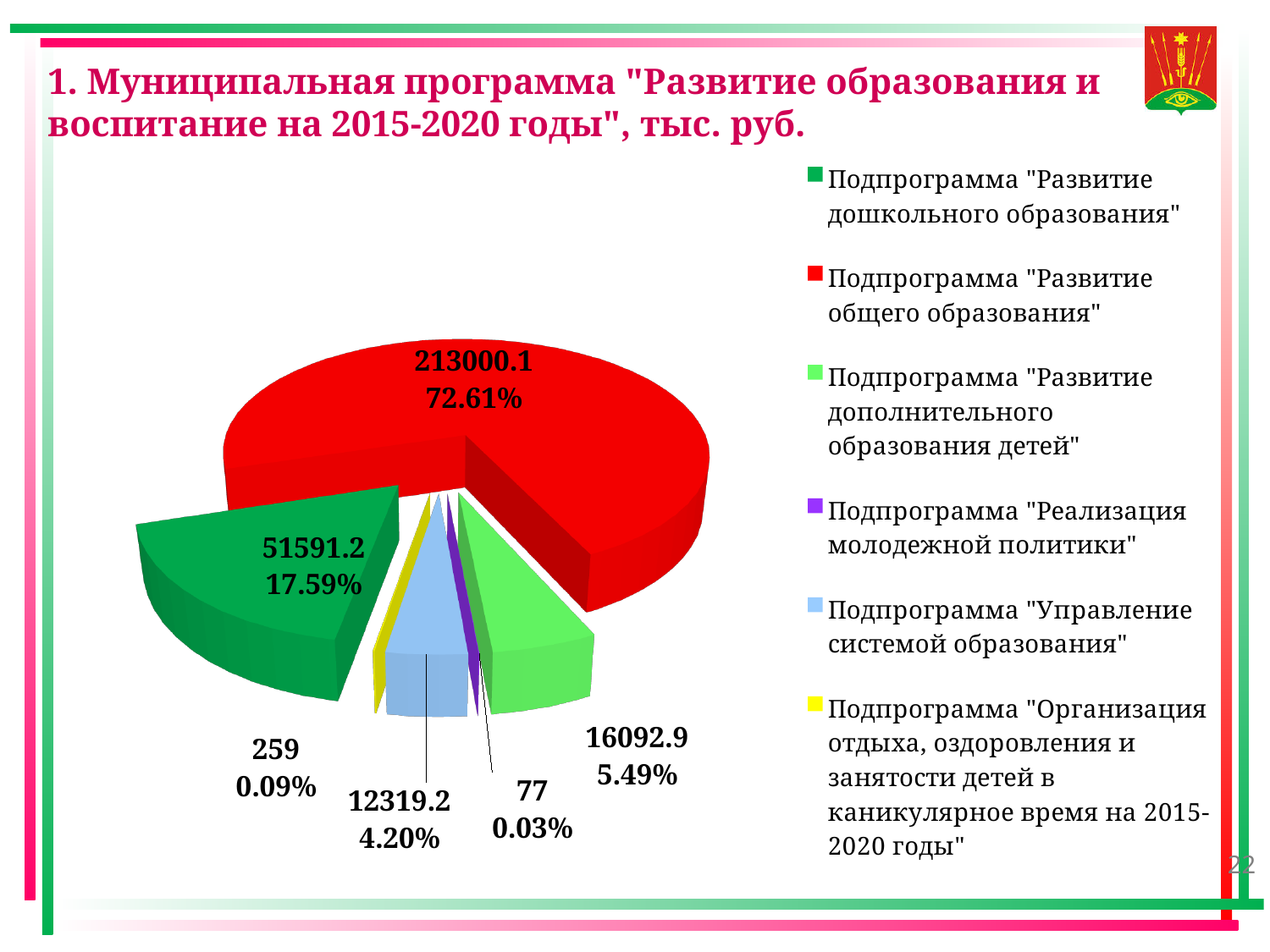
What is the difference between the values for Подпрограмма "Развитие дополнительного образования детей" and Подпрограмма "Управление системой образования"? 3773.7 Which subprogram has the largest slice of the pie? Подпрограмма "Развитие общего образования" What kind of chart is shown on the slide? Pie chart What share of the pie does Подпрограмма "Развитие дополнительного образования детей" take? 5.49% Which subprogram has the smallest slice of the pie? Подпрограмма "Реализация молодежной политики" What share of the pie does Подпрограмма "Развитие общего образования" take? 72.61% Which is larger: the value for Подпрограмма "Организация отдыха, оздоровления и занятости детей в каникулярное время на 2015-2020 годы" or for Подпрограмма "Реализация молодежной политики"? Подпрограмма "Организация отдыха, оздоровления и занятости детей в каникулярное время на 2015-2020 годы" What is the value for Подпрограмма "Развитие дошкольного образования"? 51591.2 How many slices does the pie chart have? 6 What is the value for Подпрограмма "Управление системой образования"? 12319.2 What is the value for Подпрограмма "Развитие общего образования"? 213000.1 How many entries does the legend list? 6